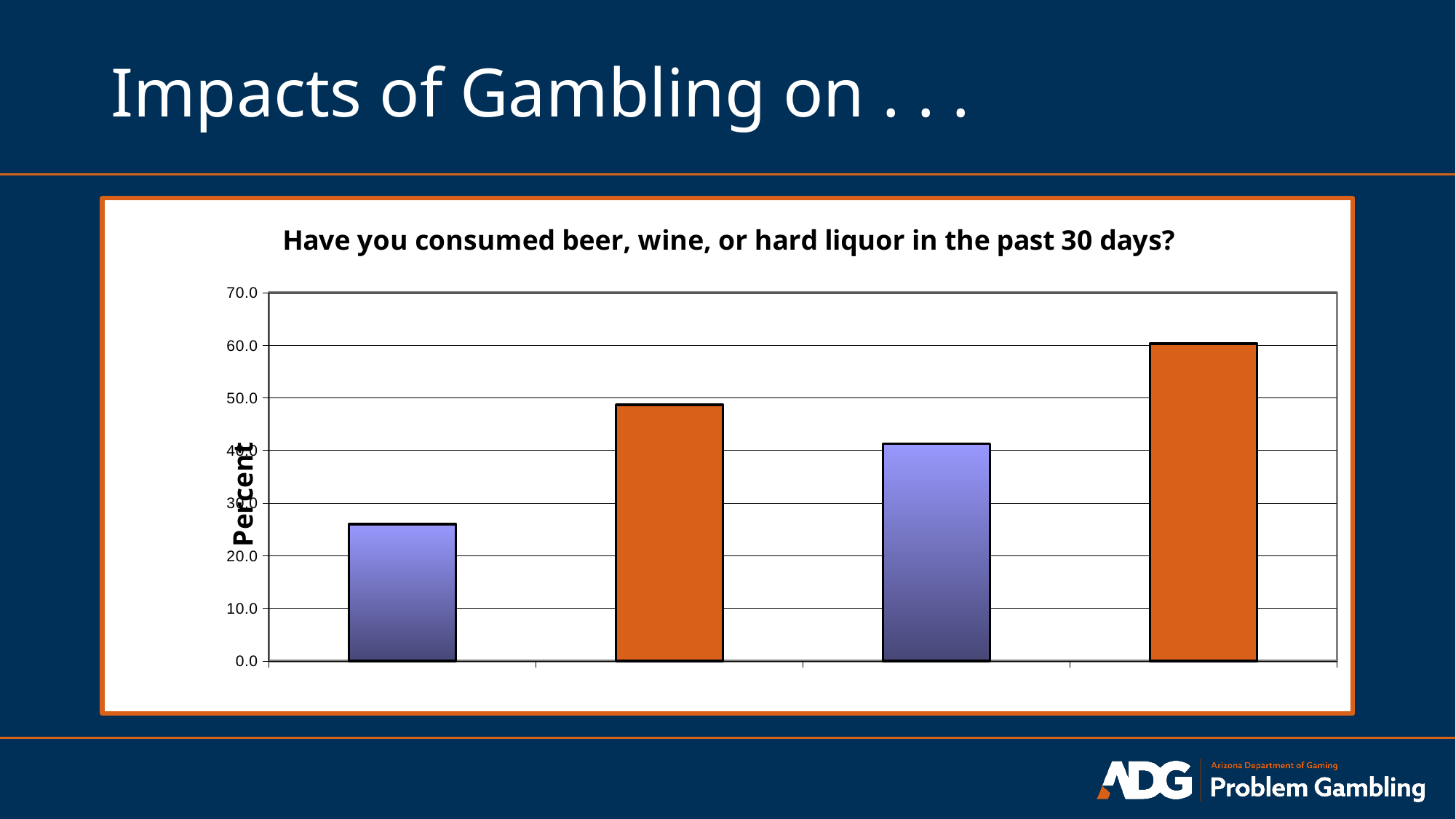
Is the value of the second bar from the left greater or less than 40.0? greater What kind of chart is shown on the slide? bar chart Which bar is the tallest in the chart? the fourth bar from the left What is the highest value shown on the vertical axis of the chart? 70.0 Which bar is the shortest in the chart? the first bar from the left Is the value of the fourth bar from the left greater or less than 50.0? greater What is the title of the chart? Have you consumed beer, wine, or hard liquor in the past 30 days? Which is larger, the second bar from the left or the third bar from the left? the second bar from the left What is the label on the vertical axis of the chart? Percent Is the value of the first bar from the left greater or less than 30.0? less How many bars are plotted in the chart? 4